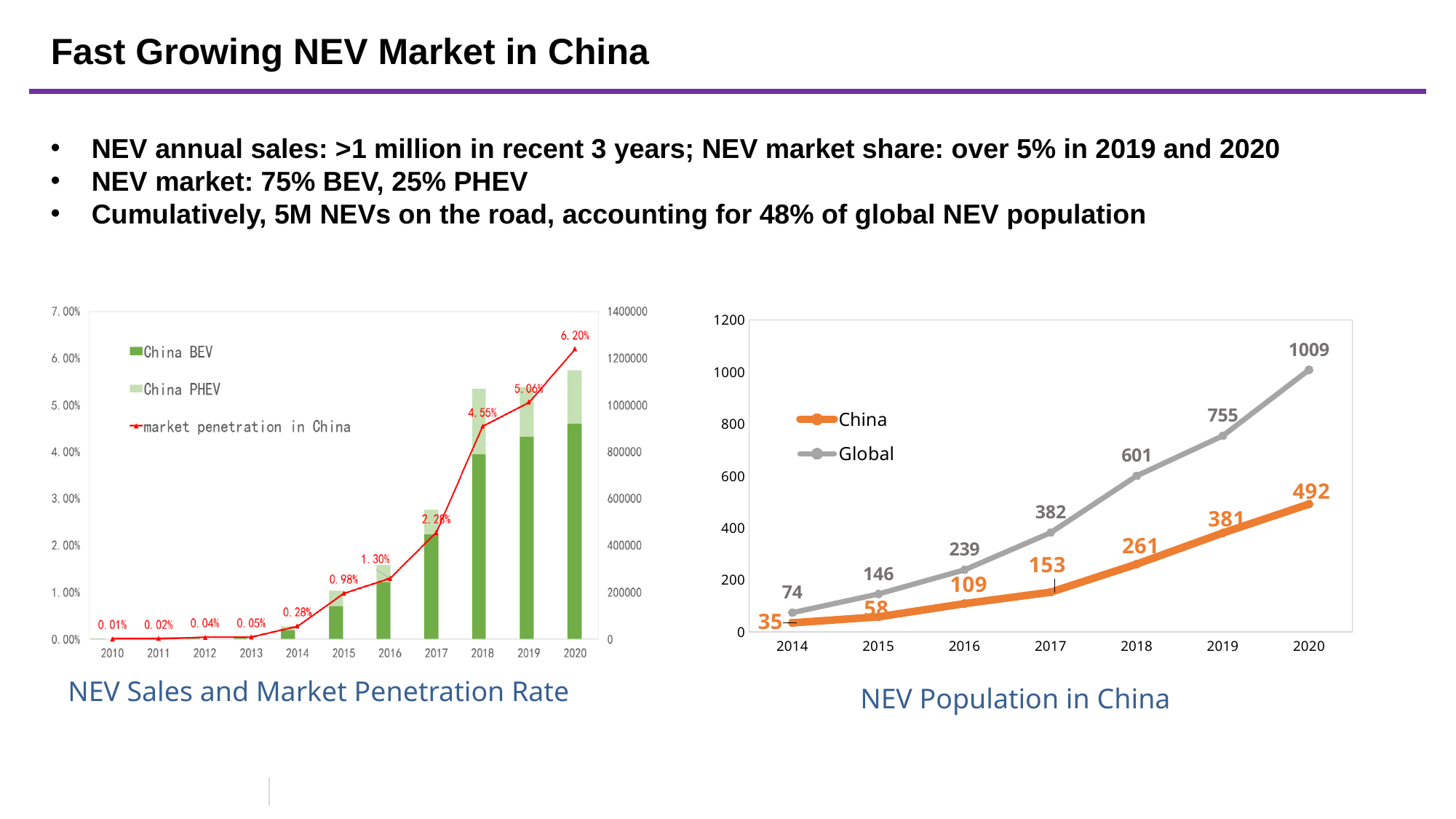
In the NEV Population in China chart, does the China series rise or fall from 2014 to 2020? rise In the NEV Sales and Market Penetration Rate chart, is the market penetration in China for 2018 greater or less than 4.00%? greater In the NEV Sales and Market Penetration Rate chart, what is the market penetration in China for 2020? 6.20% In the NEV Population in China chart, how many series does the legend list? 2 In the NEV Population in China chart, what is the difference between the Global and China values in 2019? 374 In the NEV Population in China chart, which year has the lowest China value? 2014 In the NEV Sales and Market Penetration Rate chart, what are the three legend entries? China BEV, China PHEV, market penetration in China In the NEV Sales and Market Penetration Rate chart, which year has the highest market penetration in China? 2020 In the NEV Population in China chart, what is the China value for 2018? 261 In the NEV Sales and Market Penetration Rate chart, what is the market penetration in China for 2017? 2.28% In the NEV Population in China chart, what is the Global value for 2020? 1009 In the NEV Population in China chart, how many years are shown on the x axis? 7